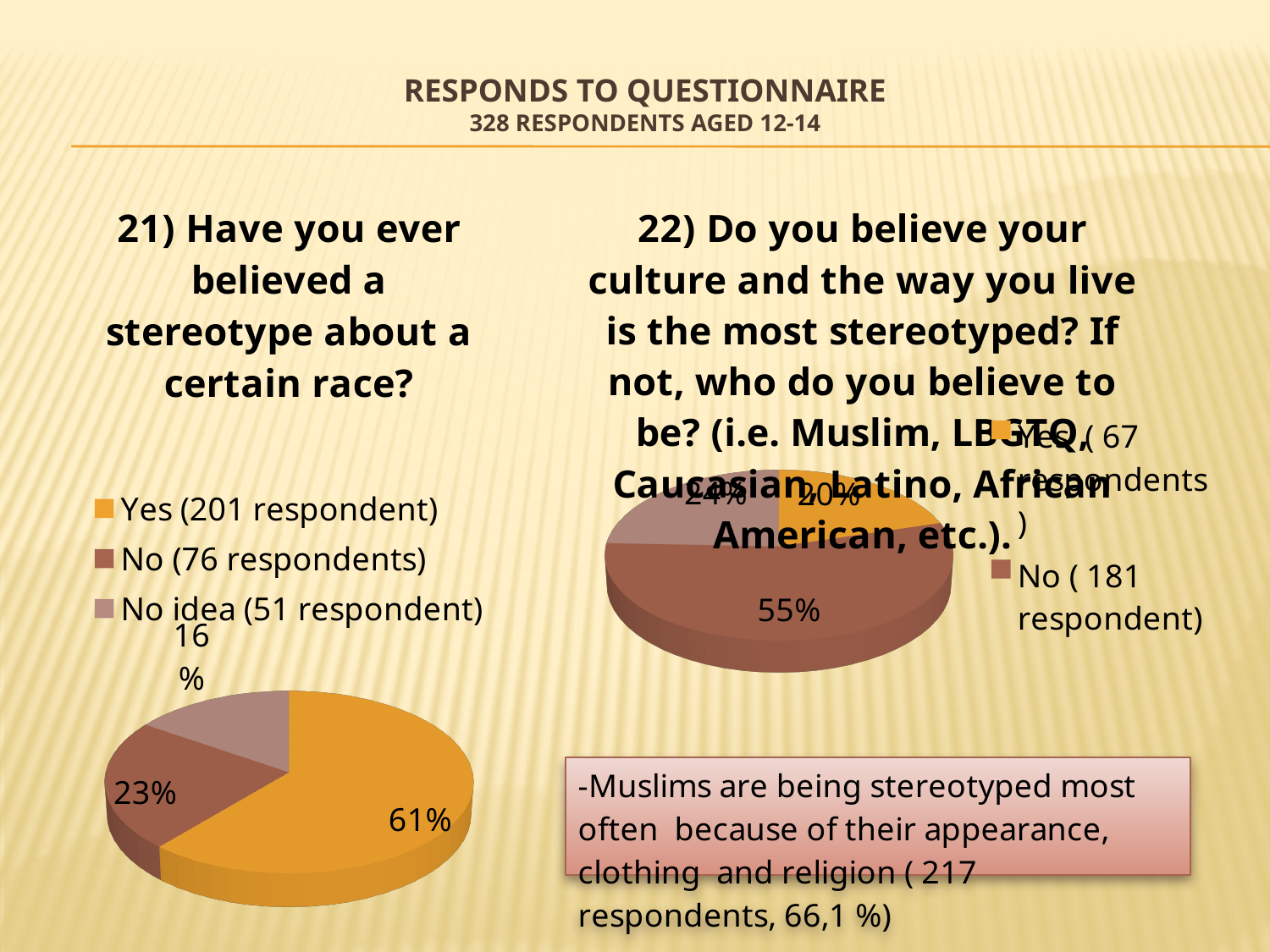
In the right pie chart (question 22), which is larger, the Yes share or the No share? No In the left pie chart (question 21), which answer has the largest share? Yes In the right pie chart (question 22), what percentage of respondents answered No? 55% In the left pie chart (question 21), what percentage of respondents answered Yes? 61% How many slices does the left pie chart (question 21) have? 3 In the left pie chart (question 21), how many respondents answered Yes according to the legend? 201 In the right pie chart (question 22), what percentage of respondents answered Yes? 20% What kind of chart is used for question 21 on the left of the slide? pie chart In the left pie chart (question 21), what percentage of respondents answered No idea? 16% In the left pie chart (question 21), how many percentage points larger is the Yes share than the No share? 38 In the left pie chart (question 21), what percentage of respondents answered No? 23% In the left pie chart (question 21), which answer has the smallest share? No idea